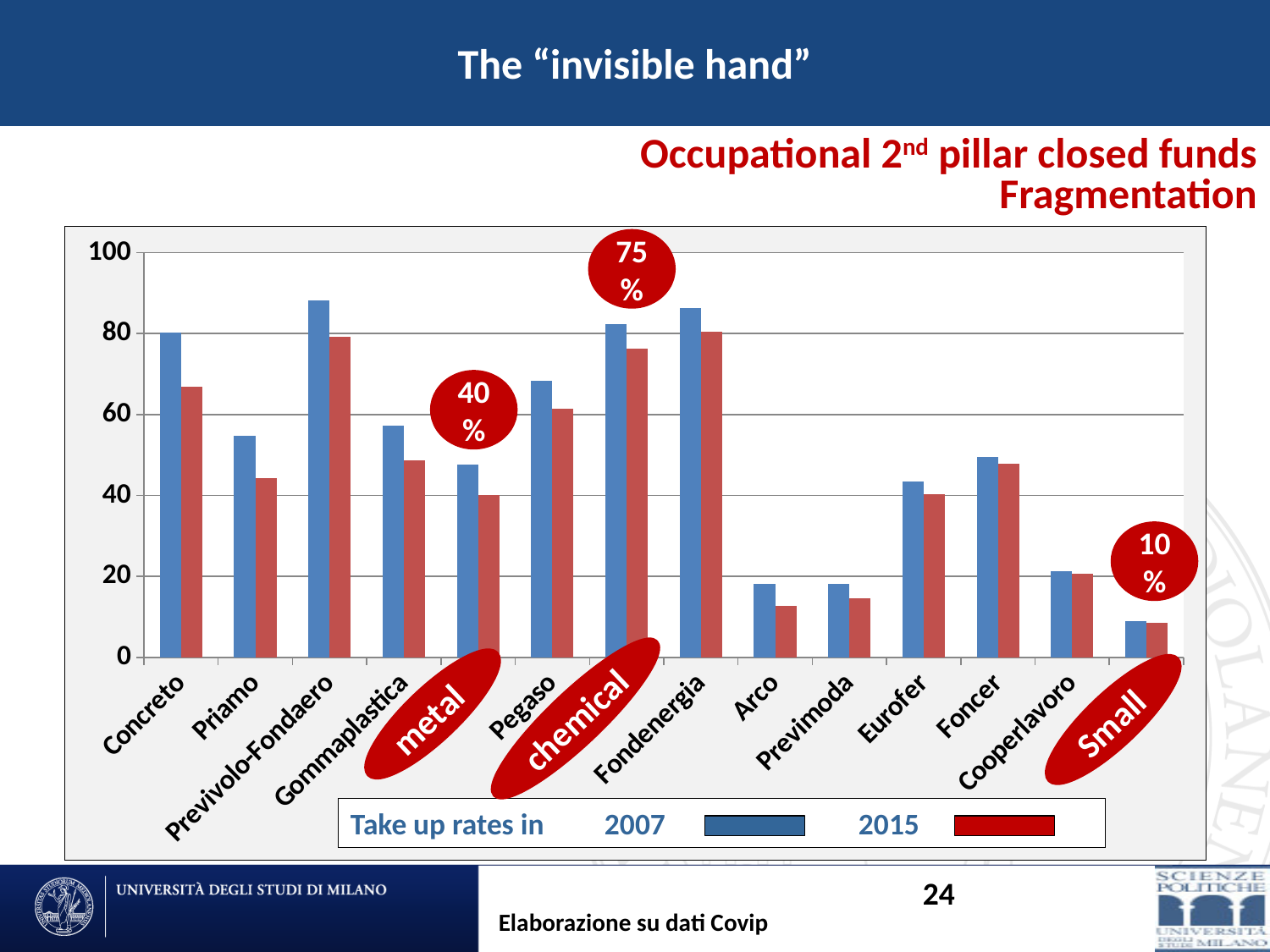
Which two years are compared in the chart's legend? 2007 and 2015 Which fund has the higher 2015 take up rate, Pegaso or Gommaplastica? Pegaso Is the 2007 take up rate for Priamo greater or less than 40? greater Which fund has the lowest take up rate in 2015? Small Which fund has the lowest take up rate in 2007? Small Is the 2015 take up rate for Pegaso greater or less than 40? greater Is the 2015 take up rate for Concreto greater or less than 60? greater What kind of chart is shown on the slide? Bar chart How many series does the legend list? 2 How many funds (categories) are shown on the x axis? 14 Which fund has the higher 2007 take up rate, Concreto or Priamo? Concreto